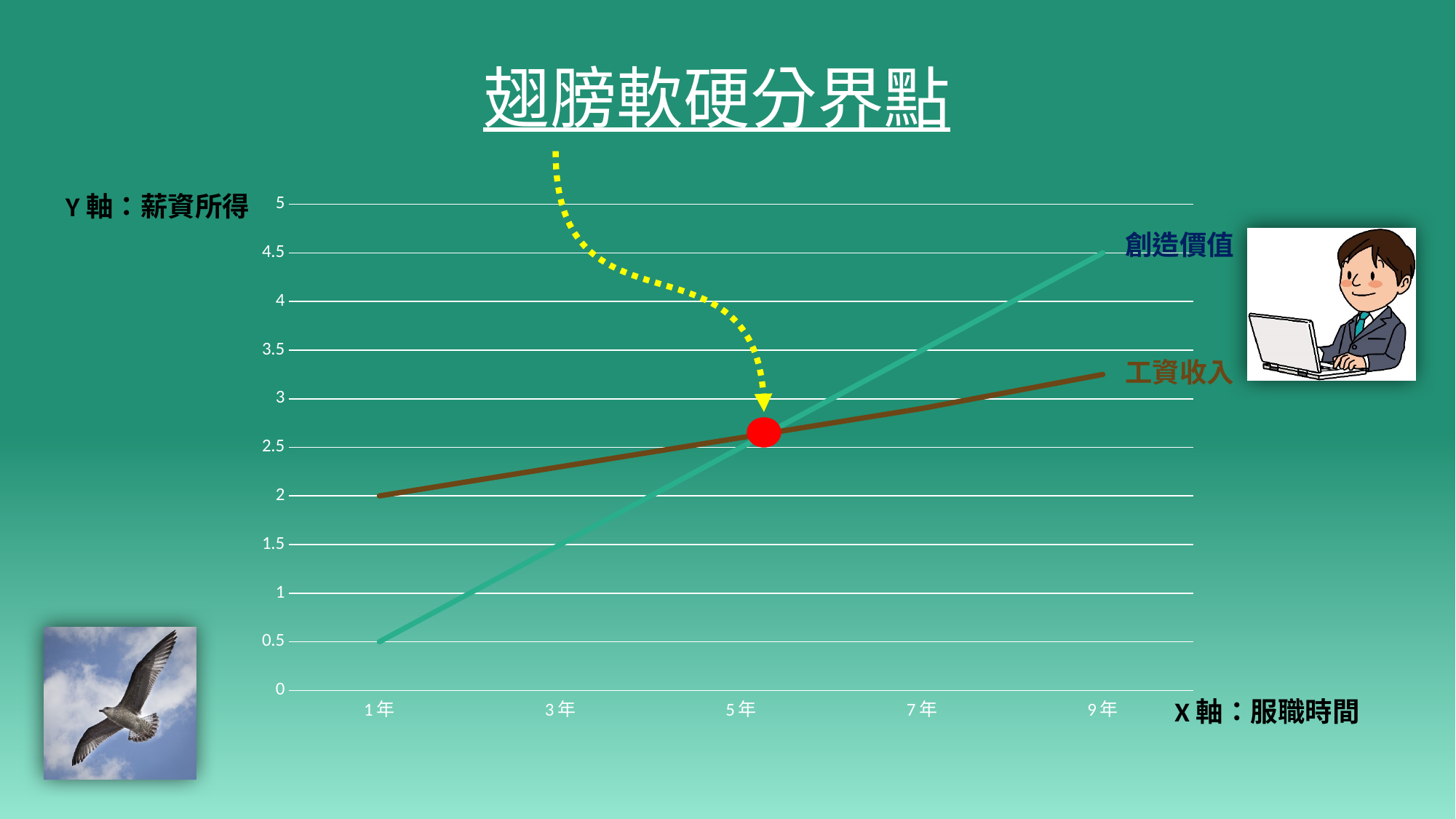
What is the value of 創造價值 at 9年? 4.5 What is the value of 創造價值 at 1年? 0.5 How many categories are shown on the x axis of the chart? 5 At 1年, which series has the higher value, 創造價值 or 工資收入? 工資收入 What is the value of 工資收入 at 1年? 2 Does the 創造價值 line rise or fall from 1年 to 9年? rise What kind of chart is shown on the slide? line chart Is the value for 工資收入 at 9年 greater or less than 3? greater How many data series (lines) are plotted on the chart? 2 At 9年, which series has the higher value, 創造價值 or 工資收入? 創造價值 By how much does 創造價值 increase from 1年 to 9年? 4 What is the title of the slide? 翅膀軟硬分界點